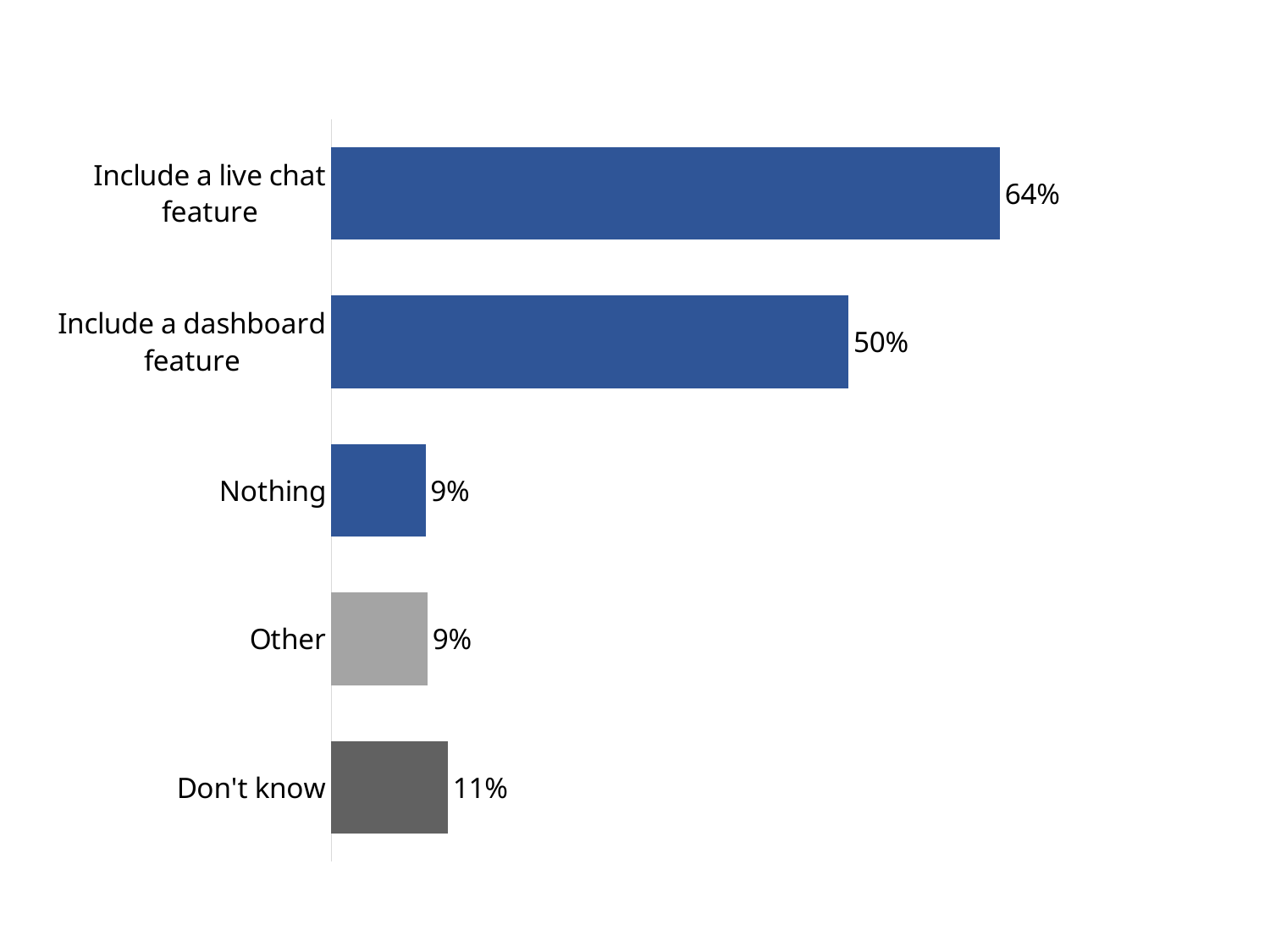
What colour is the bar for "Don't know"? Dark grey Which is larger, the value for "Don't know" or the value for "Nothing"? Don't know What is the difference between the values for "Don't know" and "Other"? 2% What is the value for "Don't know"? 11% What is the value for "Nothing"? 9% Which two categories share the same value of 9%? Nothing and Other What is the value for "Include a live chat feature"? 64% What kind of chart is shown on the slide? Bar chart Which category has the highest value? Include a live chat feature What is the value for "Include a dashboard feature"? 50% How many categories are shown in the chart? 5 What is the difference between the values for "Include a live chat feature" and "Include a dashboard feature"? 14%